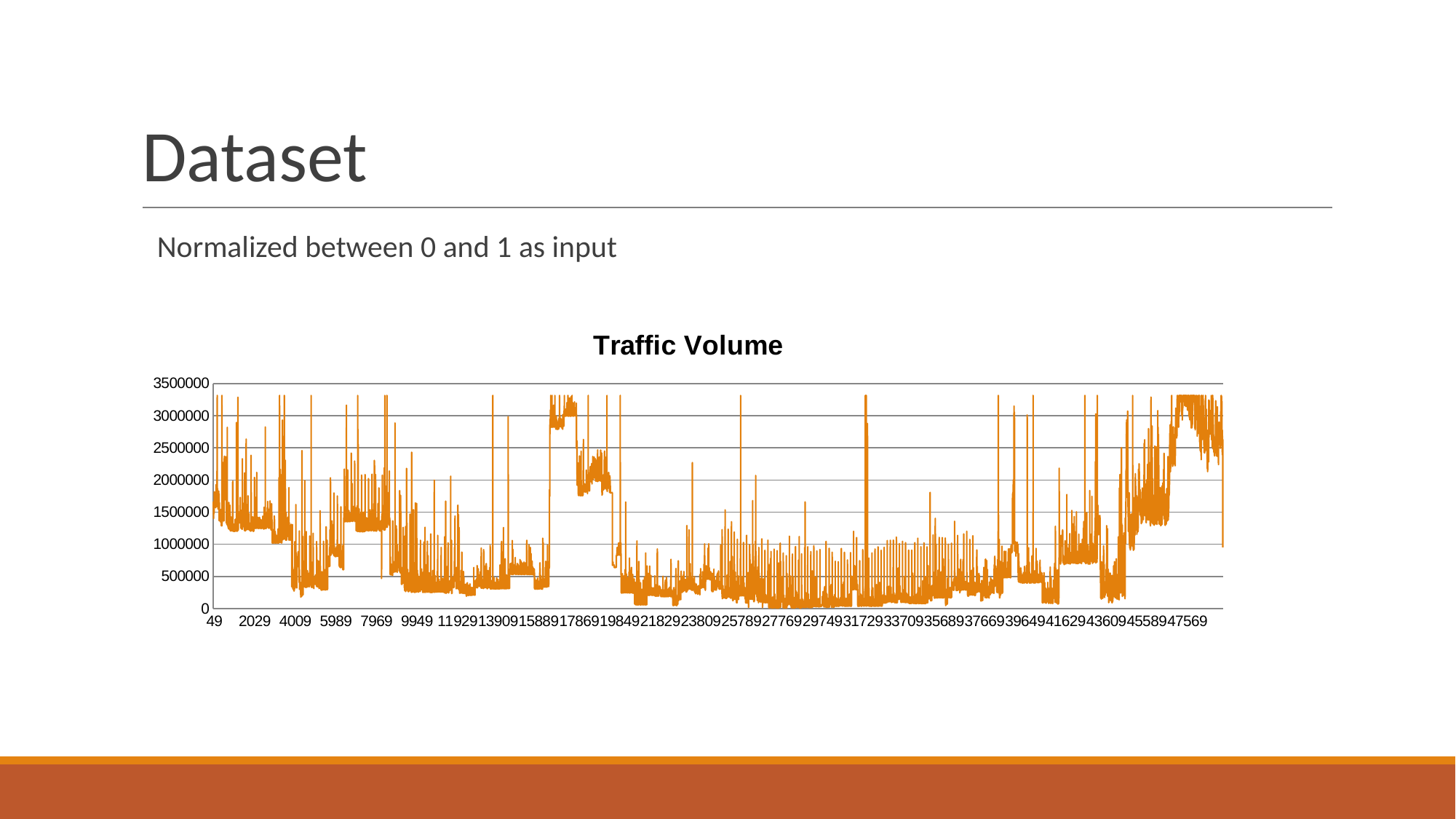
Is the lowest value plotted in the Traffic Volume chart greater or less than 500000? less What is the title of the chart? Traffic Volume What is the highest tick value shown on the y axis of the Traffic Volume chart? 3500000 What is the last label shown on the x axis of the Traffic Volume chart? 47569 What colour is the line in the Traffic Volume chart? orange What is the first label shown on the x axis of the Traffic Volume chart? 49 What is the interval between consecutive y-axis ticks in the Traffic Volume chart? 500000 What kind of chart is shown on the slide? line chart Does any value in the Traffic Volume chart reach the 3500000 gridline? no How many tick labels are printed along the x axis of the Traffic Volume chart? 25 Is the highest value plotted in the Traffic Volume chart greater or less than 3000000? greater